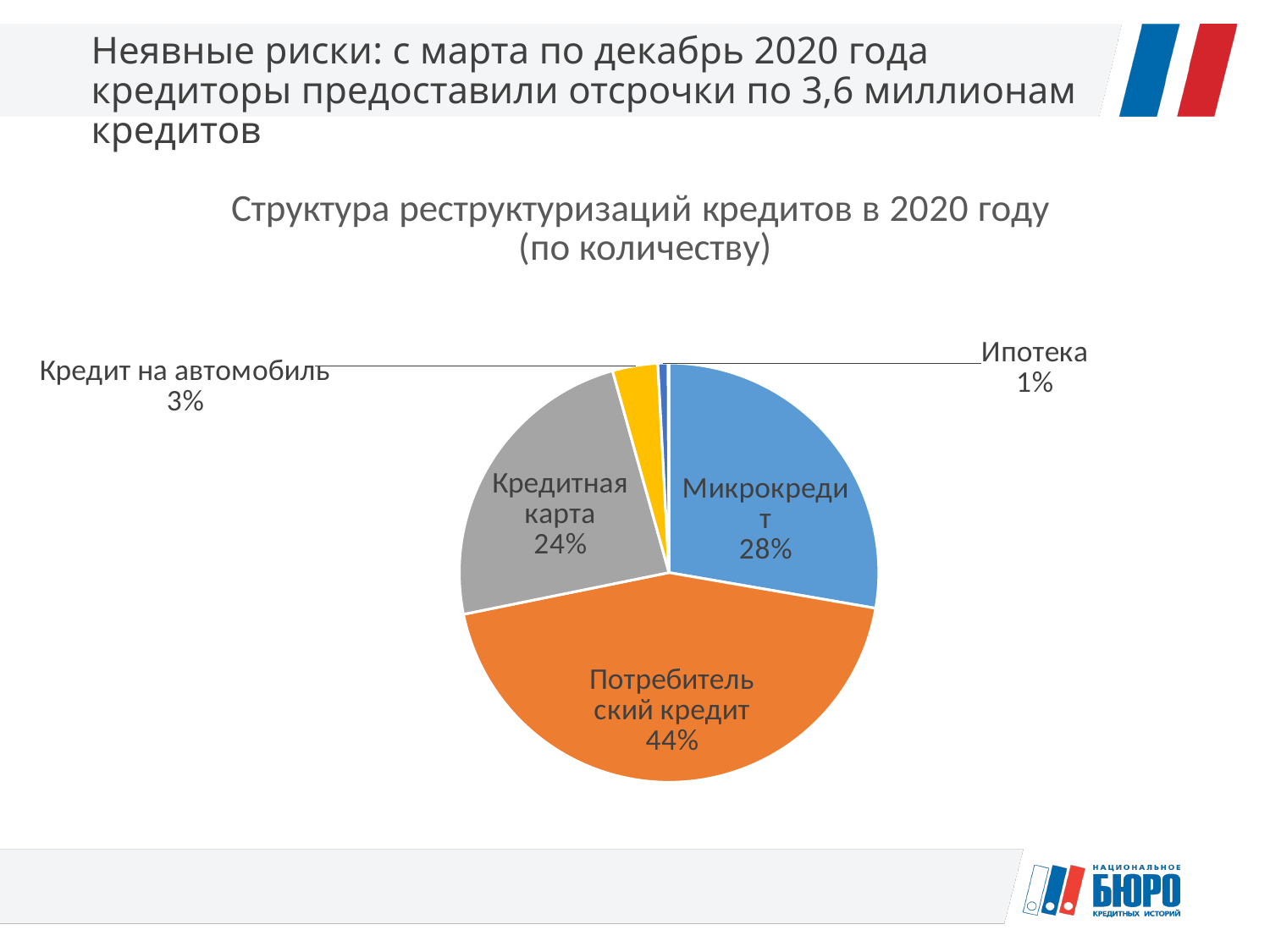
What share of the pie does Кредитная карта have? 24% Which category has the smallest slice of the pie? Ипотека What share of the pie does Кредит на автомобиль have? 3% How many categories are shown in the pie chart? 5 Which is larger, the share for Микрокредит or the share for Кредитная карта? Микрокредит What share of the pie does Микрокредит have? 28% What is the title of the chart? Структура реструктуризаций кредитов в 2020 году (по количеству) What type of chart is shown on the slide? pie chart What is the difference in percentage points between Потребительский кредит and Микрокредит? 16 Which category has the largest slice of the pie? Потребительский кредит